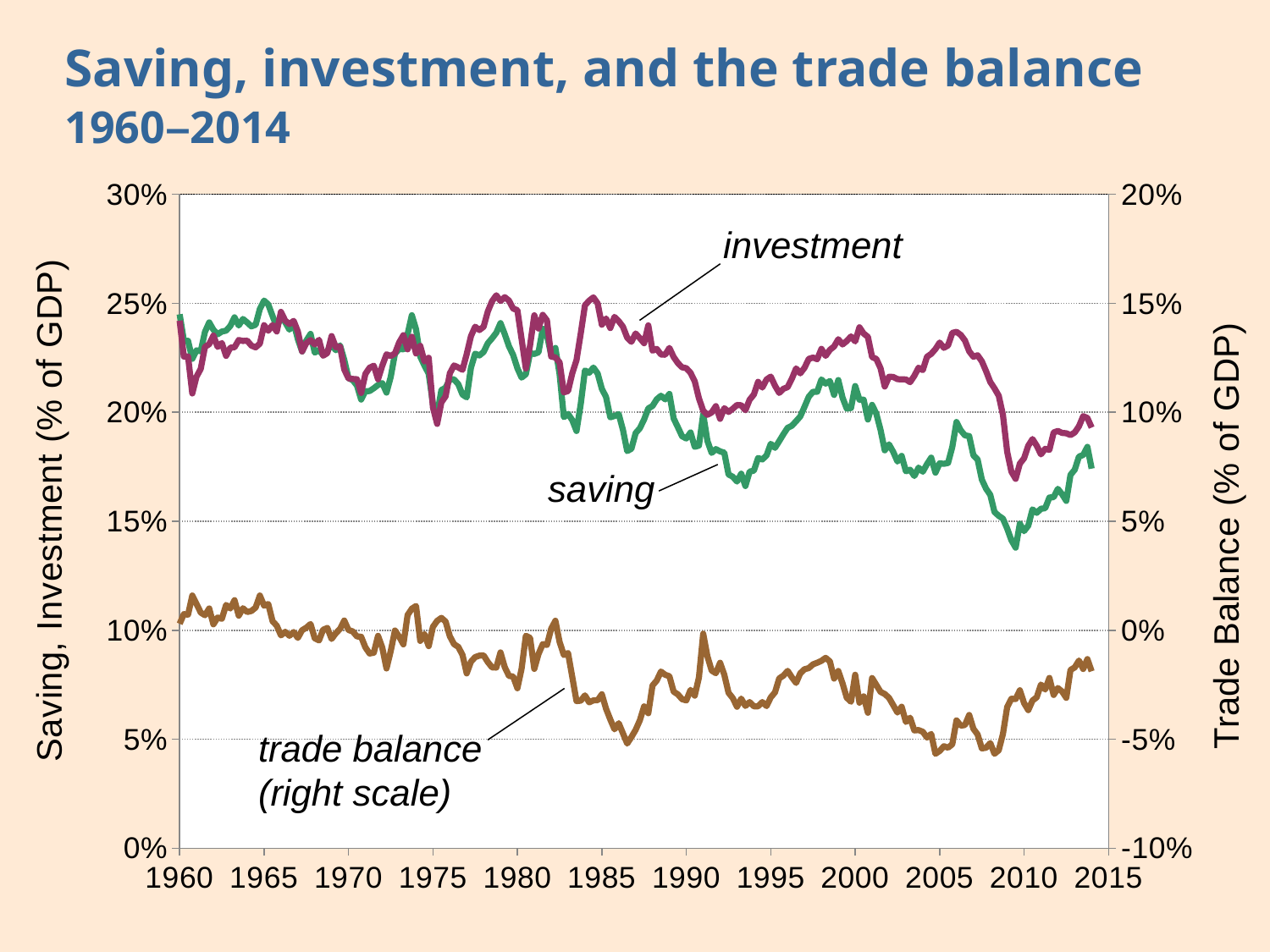
In 2005, which is larger, investment or saving? investment Is the value for investment in 1960 greater or less than 20%? greater How many series are plotted on the chart? 3 Does the trade balance overall rise or fall from 1960 to 2014? fall What kind of chart is shown on the slide? line chart Which series is plotted against the right-hand scale? trade balance Is the trade balance in 1987 greater or less than 0%? less Does the saving series overall rise or fall from 1960 to 2014? fall Is the trade balance in 1960 greater or less than 0%? greater What is the label of the left vertical axis? Saving, Investment (% of GDP)